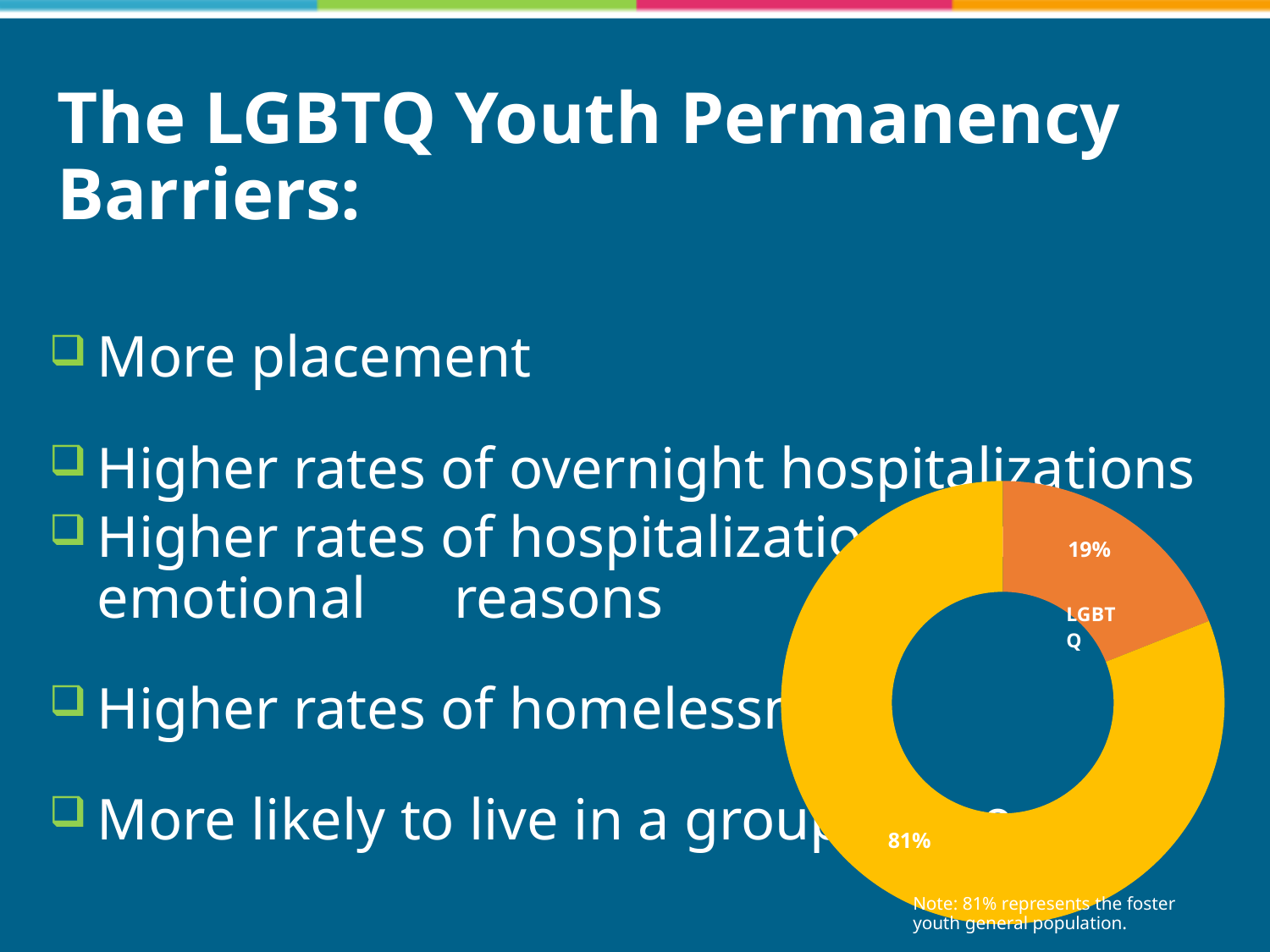
What percentage does the LGBTQ slice of the doughnut chart show? 19% What is the largest value shown in the doughnut chart? 81% What share of the doughnut chart does the LGBTQ slice represent? 19% What is the difference between the two slices of the doughnut chart? 62% Is the value for the LGBTQ slice greater or less than 50%? less What colour is the LGBTQ slice in the doughnut chart? orange What kind of chart is shown on the slide? doughnut chart Which slice is larger in the doughnut chart, the LGBTQ slice or the other slice? the other slice (81%) What is the value of the larger slice in the doughnut chart? 81% What is the smallest value shown in the doughnut chart? 19% According to the note on the slide, what does the 81% slice represent? the foster youth general population How many slices does the doughnut chart have? 2